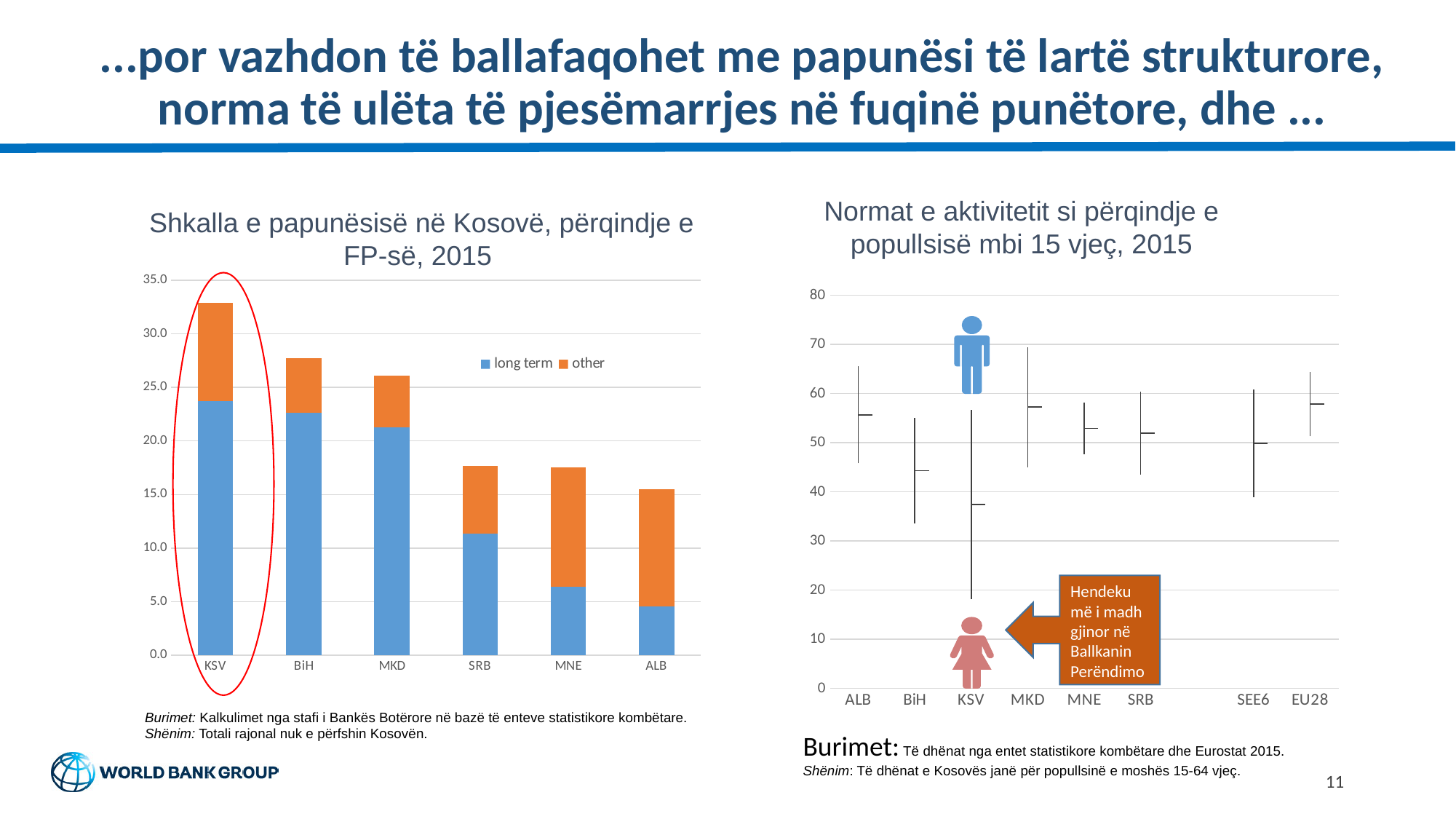
How many series does the legend of the left chart, 'Shkalla e papunësisë në Kosovë', list? 2 In the left chart, 'Shkalla e papunësisë në Kosovë', which country has the lowest total unemployment rate? ALB What kind of chart is the left chart, 'Shkalla e papunësisë në Kosovë, përqindje e FP-së, 2015'? Stacked bar chart In the left chart, 'Shkalla e papunësisë në Kosovë', is the total value for KSV greater or less than 30.0? greater In the left chart, 'Shkalla e papunësisë në Kosovë', which country has the highest total unemployment rate? KSV In the left chart, 'Shkalla e papunësisë në Kosovë', which is larger: the 'long term' value for KSV or the 'long term' value for MNE? KSV In the left chart, 'Shkalla e papunësisë në Kosovë', which colour represents the 'other' series? Orange How many categories are shown on the x axis of the right chart, 'Normat e aktivitetit si përqindje e popullsisë mbi 15 vjeç, 2015'? 8 In the left chart, 'Shkalla e papunësisë në Kosovë', do the total bar heights rise or fall from left to right along the x axis? fall How many countries are shown on the x axis of the left chart, 'Shkalla e papunësisë në Kosovë'? 6 In the right chart, 'Normat e aktivitetit si përqindje e popullsisë mbi 15 vjeç, 2015', is the lowest point of the KSV line greater or less than 20? less In the left chart, 'Shkalla e papunësisë në Kosovë', is the 'long term' value for ALB greater or less than 10.0? less